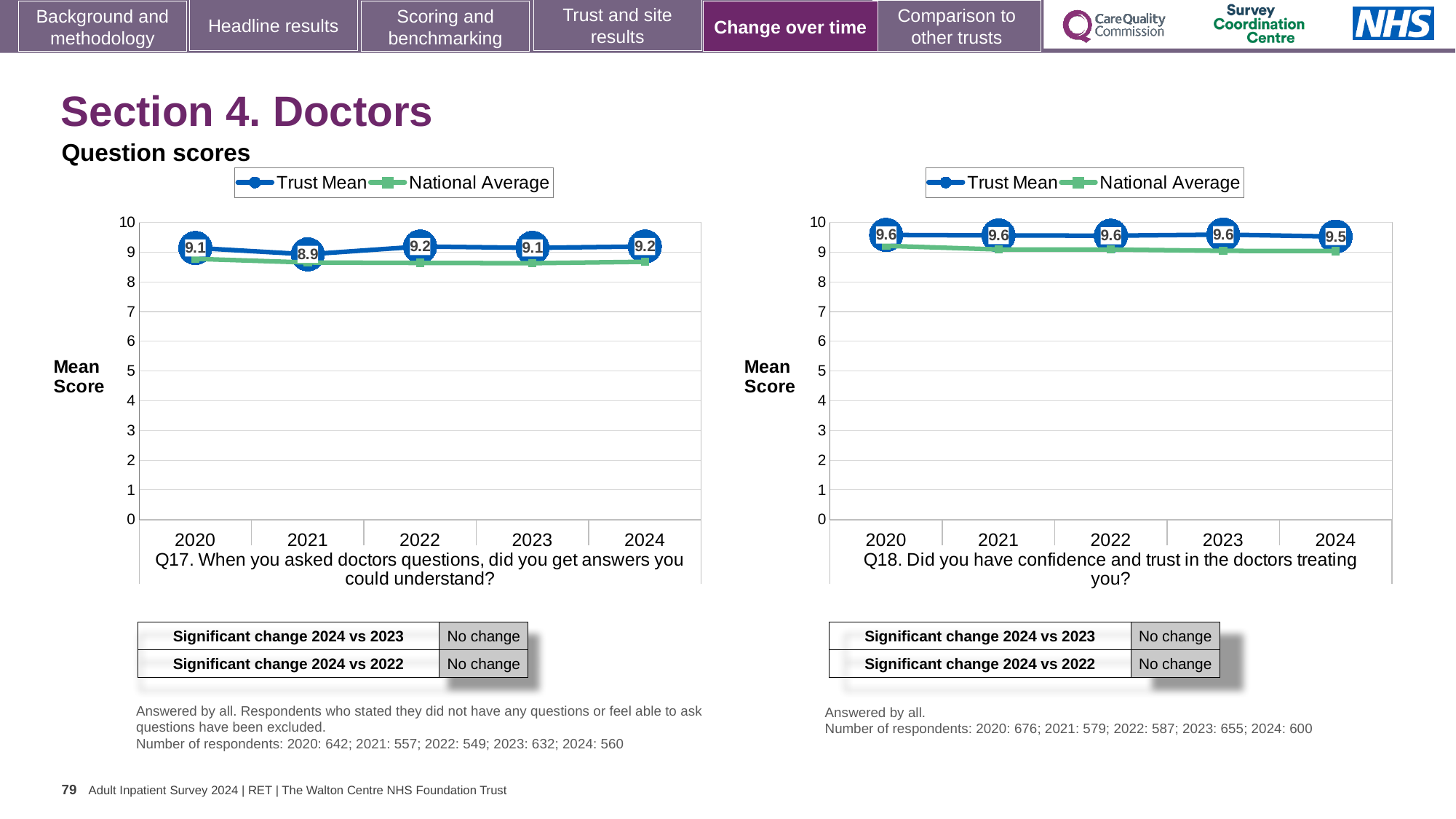
How many series does the legend of the Q18 chart list? 2 In the Q18 chart, which year has the lowest Trust Mean score? 2024 How many years are plotted on the x axis of the Q17 chart? 5 What type of chart is the Q17 chart? Line chart In the Q17 chart, what is the Trust Mean score for 2021? 8.9 In the Q18 chart, is the National Average for 2024 greater or less than 8? greater In the Q17 chart, what is the Trust Mean score for 2024? 9.2 In the Q17 chart, what is the difference between the Trust Mean scores for 2022 and 2021? 0.3 In the Q17 chart, is the Trust Mean for 2023 or the Trust Mean for 2021 larger? 2023 In the Q17 chart, which year has the lowest Trust Mean score? 2021 In the Q18 chart, what is the Trust Mean score for 2024? 9.5 In the Q18 chart, what is the Trust Mean score for 2020? 9.6